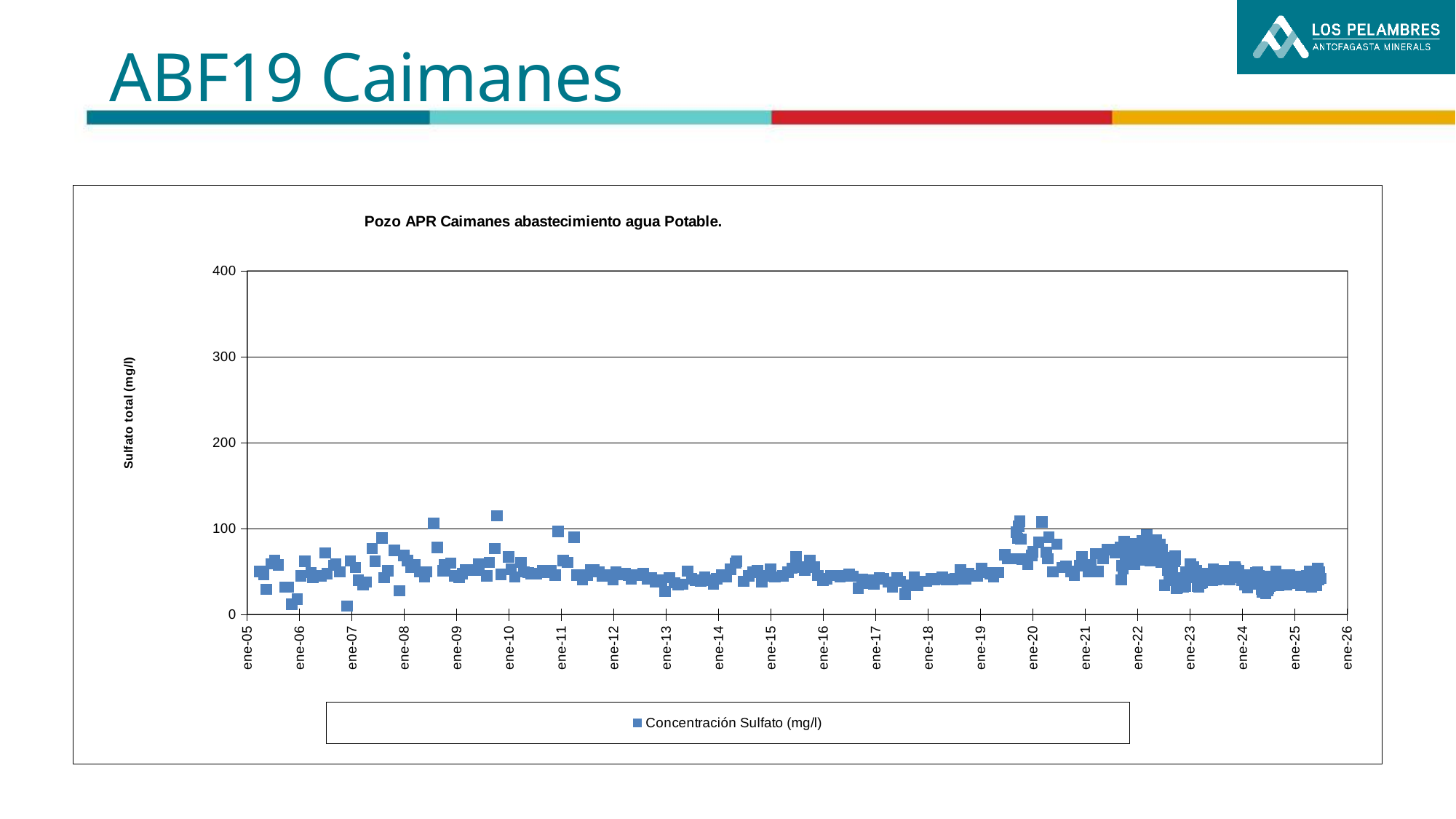
What is the name of the series shown in the legend? Concentración Sulfato (mg/l) Is the lowest plotted point near ene-07 greater or less than 50? less How many series does the chart legend list? 1 Are the plotted values around ene-17 greater or less than 100? less What is the title of the chart? Pozo APR Caimanes abastecimiento agua Potable. Are all the plotted sulfate values greater or less than 200? less What kind of chart is shown on the slide? scatter chart